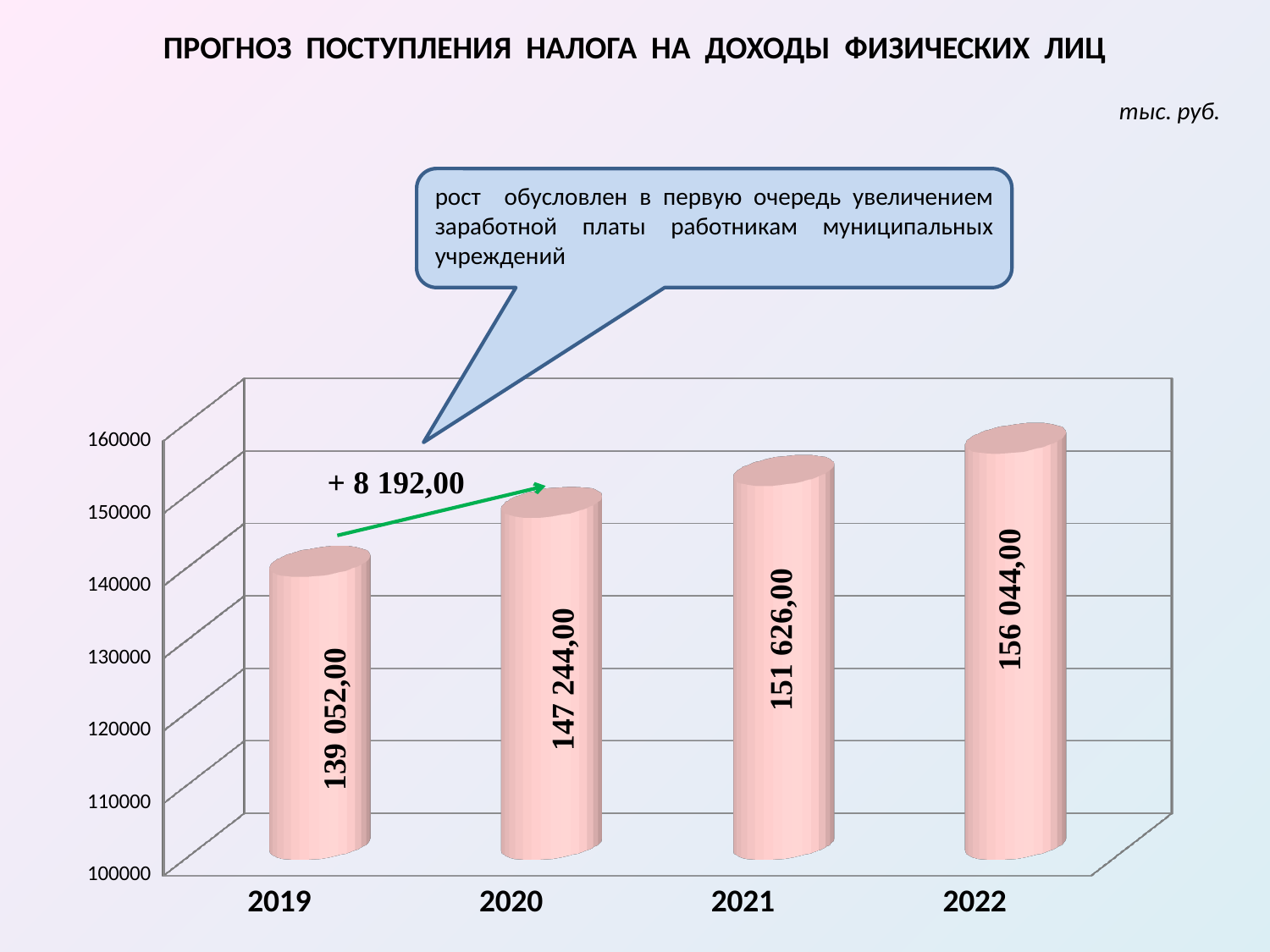
Which year has the highest value? 2022 What is the difference between the values for 2020 and 2019? 8 192,00 What is the difference between the values for 2022 and 2021? 4 418,00 What unit is indicated for the chart values? тыс. руб. Do the values rise or fall from 2019 to 2022? Rise How many years are shown on the chart? 4 What is the value for 2019? 139 052,00 Which is larger, the value for 2020 or the value for 2021? 2021 What is the value for 2022? 156 044,00 What is the value for 2021? 151 626,00 What kind of chart is shown on the slide? Bar chart Which year has the lowest value? 2019